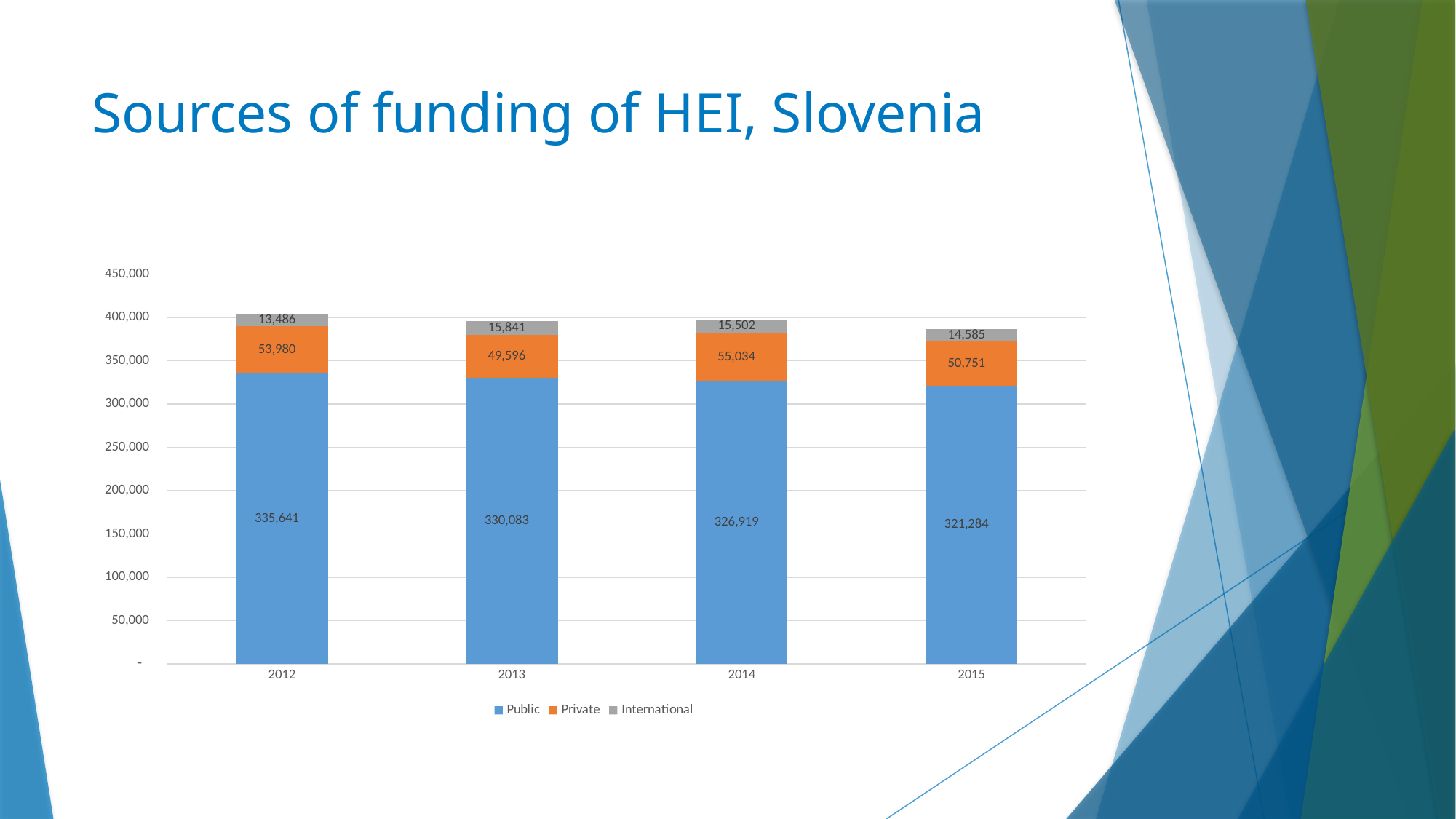
Which is larger, Private funding in 2013 or in 2014? 2014 How many series does the legend list? 3 Which year has the highest Public funding? 2012 What is the total of the stacked bar for 2012? 403,107 Does Public funding rise or fall from 2012 to 2015? Fall What is the Public funding value for 2012? 335,641 What kind of chart is shown? Stacked bar chart How many years are shown on the x axis? 4 What is the difference between Public funding in 2012 and 2015? 14,357 What is the International funding value for 2015? 14,585 What is the Private funding value for 2014? 55,034 Which year has the lowest International funding? 2012